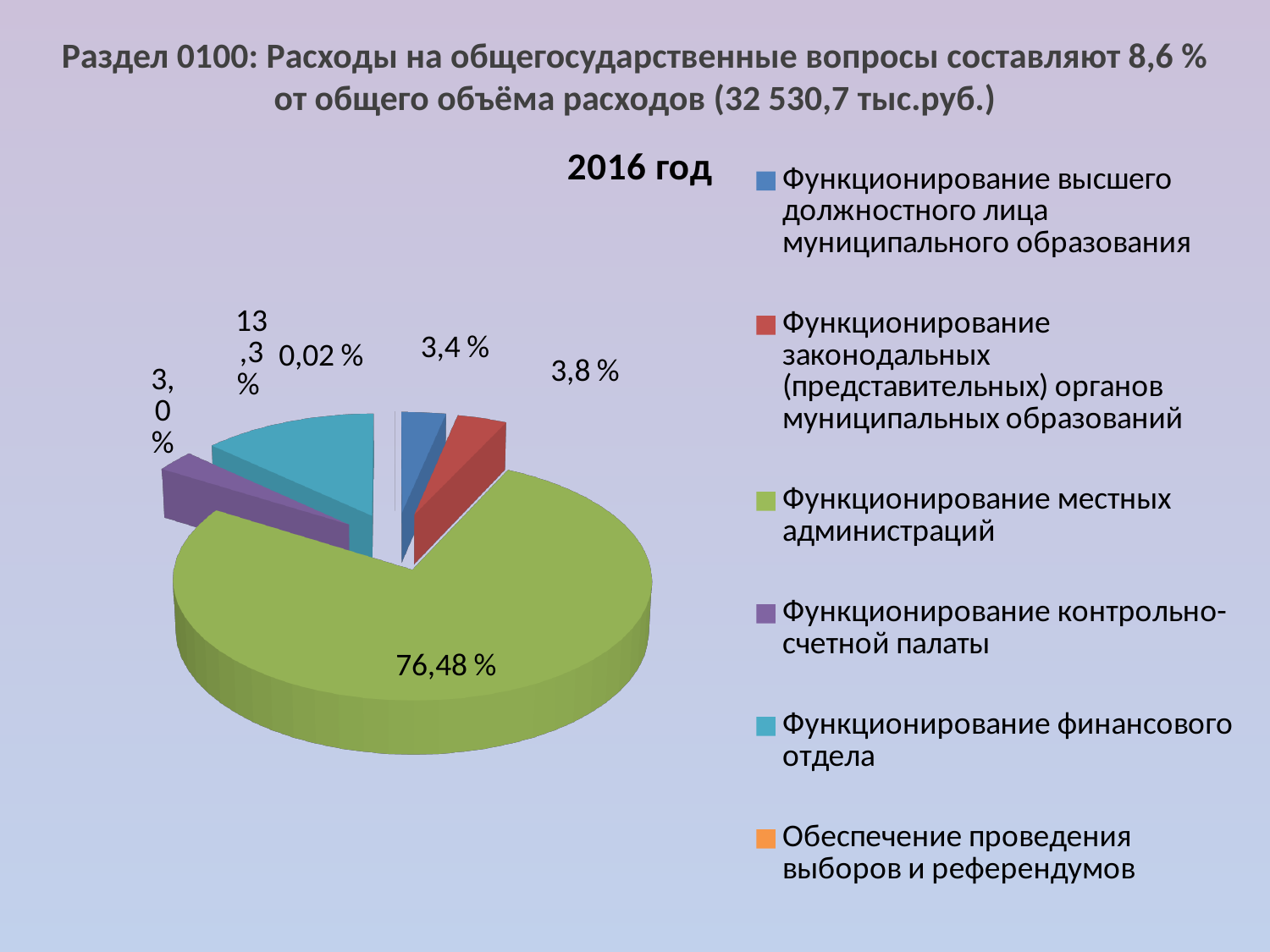
Which category has the largest share of the pie? Функционирование местных администраций Which is larger: the share for Функционирование финансового отдела or the share for Функционирование контрольно-счетной палаты? Функционирование финансового отдела How many categories does the legend list? 6 What share of the pie is labelled for Функционирование высшего должностного лица муниципального образования? 3,4 % What is the difference in percentage points between the shares for Функционирование местных администраций and Функционирование финансового отдела? 63,18 % Which category has the smallest share of the pie? Обеспечение проведения выборов и референдумов What is the chart's title? 2016 год What share of the pie is labelled for Функционирование законодательных (представительных) органов муниципальных образований? 3,8 % What share of the pie is labelled for Обеспечение проведения выборов и референдумов? 0,02 % What type of chart is shown on the slide? pie chart What share of the pie is labelled for Функционирование местных администраций? 76,48 % What share of the pie is labelled for Функционирование финансового отдела? 13,3 %